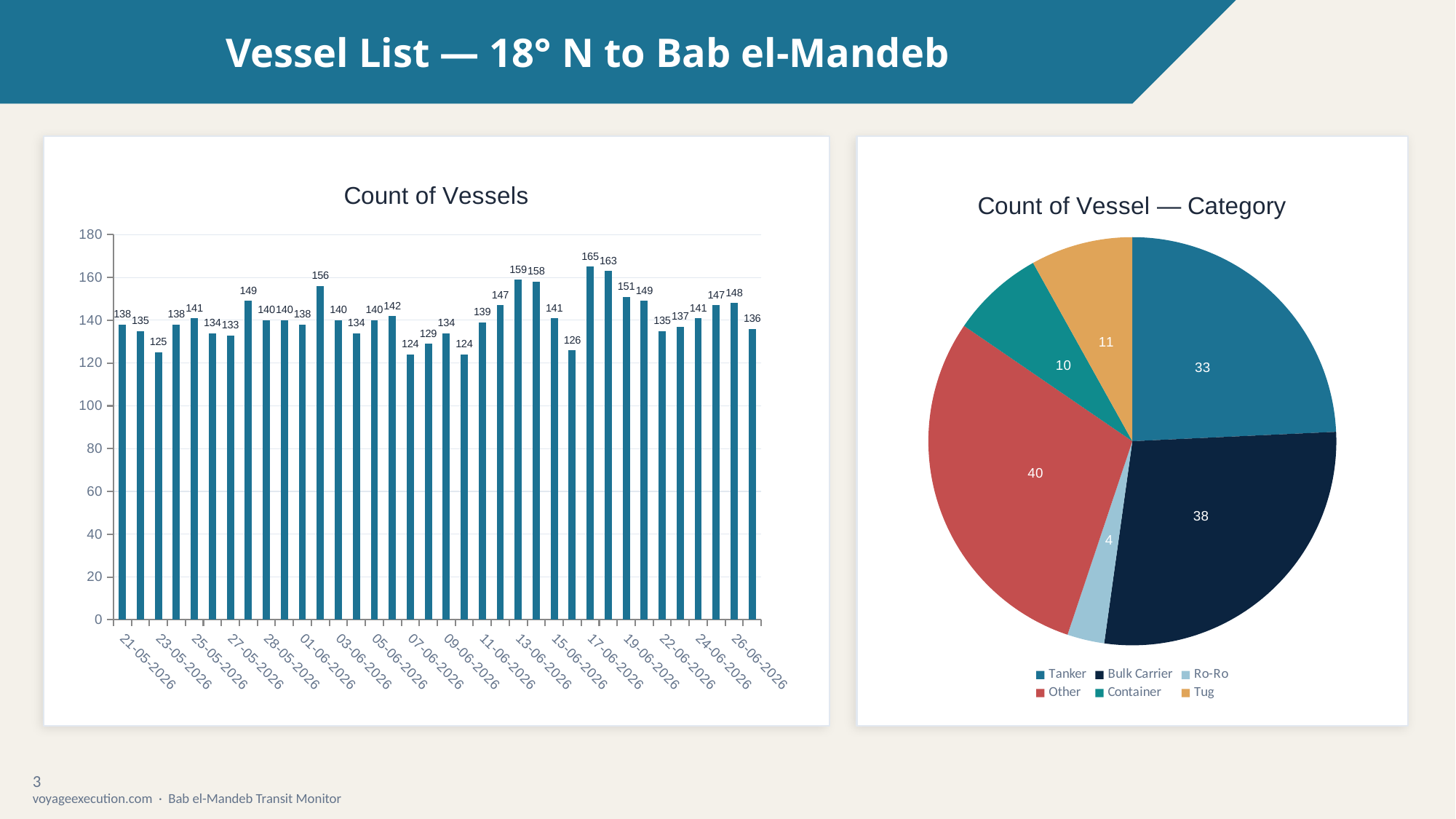
In the 'Count of Vessel — Category' pie chart, which category has the largest count? Other In the 'Count of Vessels' bar chart, what is the value for 21-05-2026? 138 In the 'Count of Vessel — Category' pie chart, what is the difference between the counts for Other and Tanker? 7 In the 'Count of Vessels' bar chart, what is the highest value shown? 165 What kind of chart is the 'Count of Vessels' chart on the left? bar chart In the 'Count of Vessels' bar chart, is the value for 17-06-2026 greater or less than 160? greater In the 'Count of Vessel — Category' pie chart, what is the total of all slices? 136 In the 'Count of Vessel — Category' pie chart, which category has the smallest count? Ro-Ro In the 'Count of Vessel — Category' pie chart, which is larger: Bulk Carrier or Tanker? Bulk Carrier How many categories does the legend of the 'Count of Vessel — Category' pie chart list? 6 In the 'Count of Vessel — Category' pie chart, what is the count for Bulk Carrier? 38 What kind of chart is the 'Count of Vessel — Category' chart on the right? pie chart